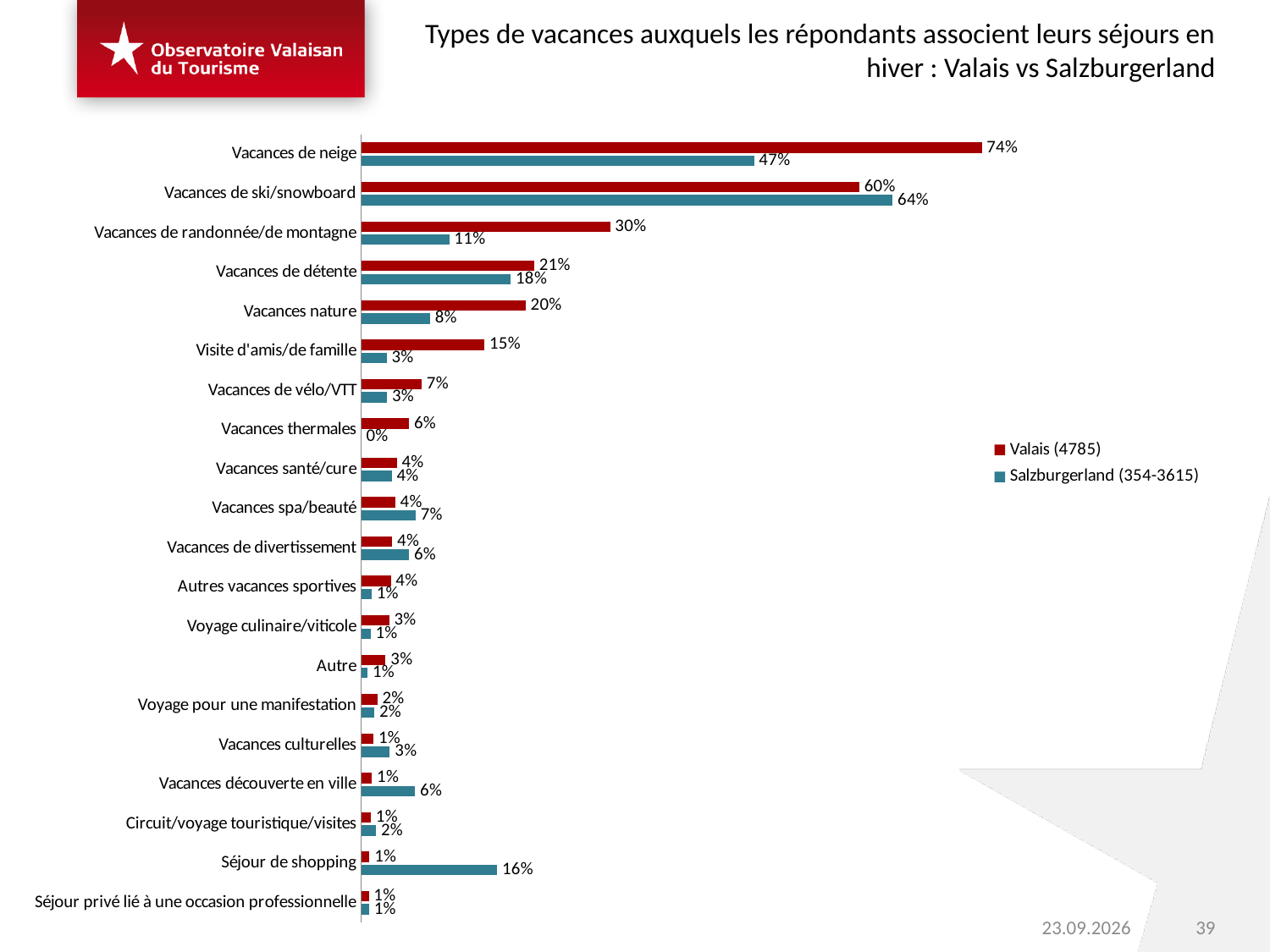
What is the difference between the Valais and Salzburgerland values for 'Vacances de randonnée/de montagne'? 19% For 'Vacances de ski/snowboard', which series has the larger value, Valais or Salzburgerland? Salzburgerland What is the value for Salzburgerland for 'Vacances de ski/snowboard'? 64% What kind of chart is shown on the slide? bar chart What is the title of the chart? Types de vacances auxquels les répondants associent leurs séjours en hiver : Valais vs Salzburgerland What is the value for Valais for 'Vacances de neige'? 74% Which category has the highest value for Salzburgerland? Vacances de ski/snowboard How many series does the legend list? 2 Which category has the highest value for Valais? Vacances de neige What is the value for Salzburgerland for 'Séjour de shopping'? 16% Which category has the lowest value for Salzburgerland? Vacances thermales How many categories are plotted on the chart? 20